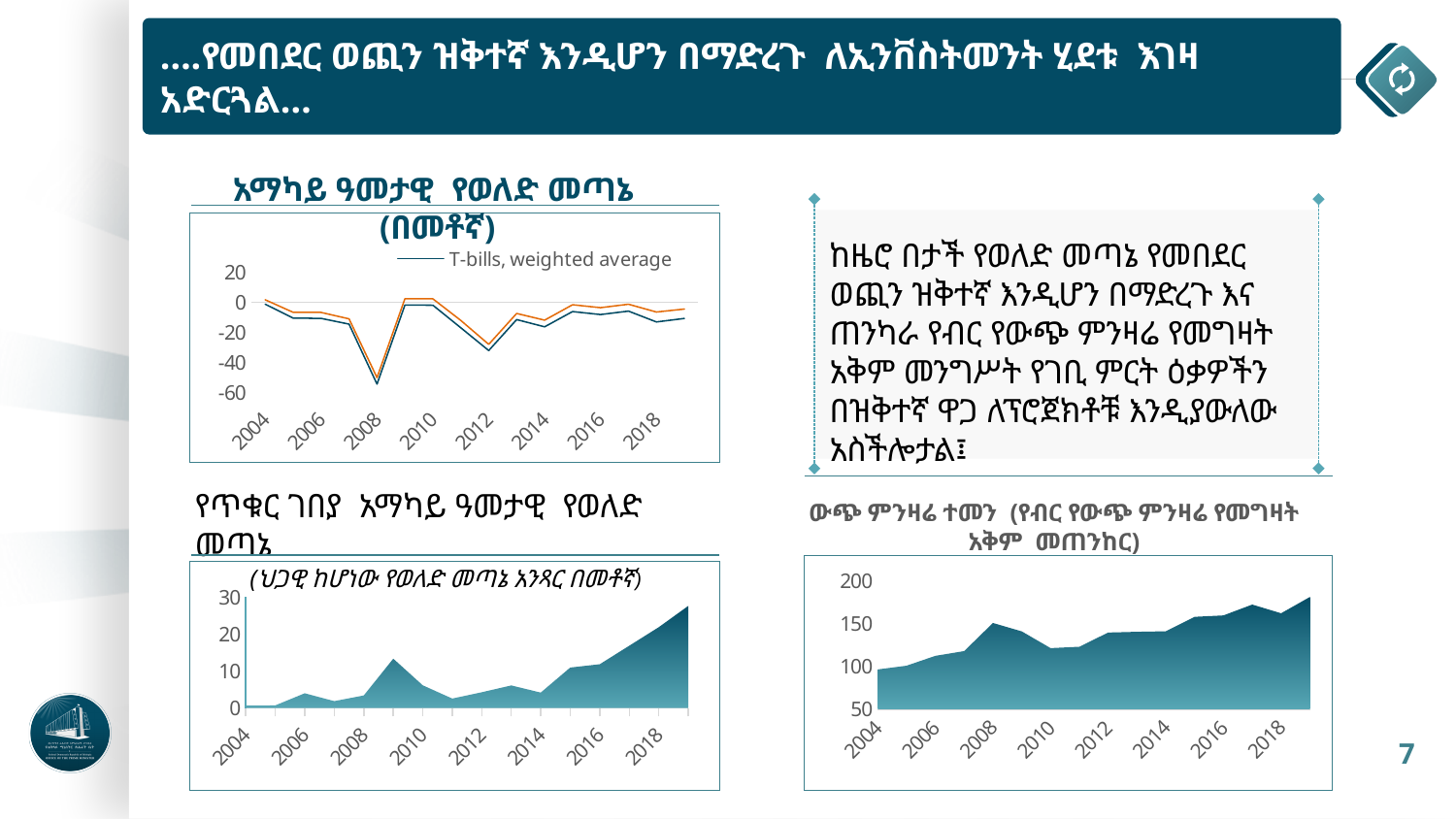
In the bottom-right area chart, is the value for 2018 greater or less than 150? greater In the bottom-right area chart, do the values generally rise or fall from 2004 to 2018? rise What kind of chart is the bottom-left chart on the slide? area chart How many year labels are shown on the x axis of the bottom-right area chart? 8 In the top-left line chart, which series name is shown in the legend? T-bills, weighted average In the top-left line chart, in which year do the lines reach their lowest point? 2008 In the bottom-left area chart, is the value for 2012 greater or less than 10? less In the bottom-left area chart, is the value at the end of the series (2019) greater or less than 20? greater In the top-left line chart, what is the lowest value shown on the vertical axis? -60 What kind of chart is the top-left chart on the slide? line chart In the bottom-left area chart, do the values generally rise or fall from 2014 to the end of the series? rise